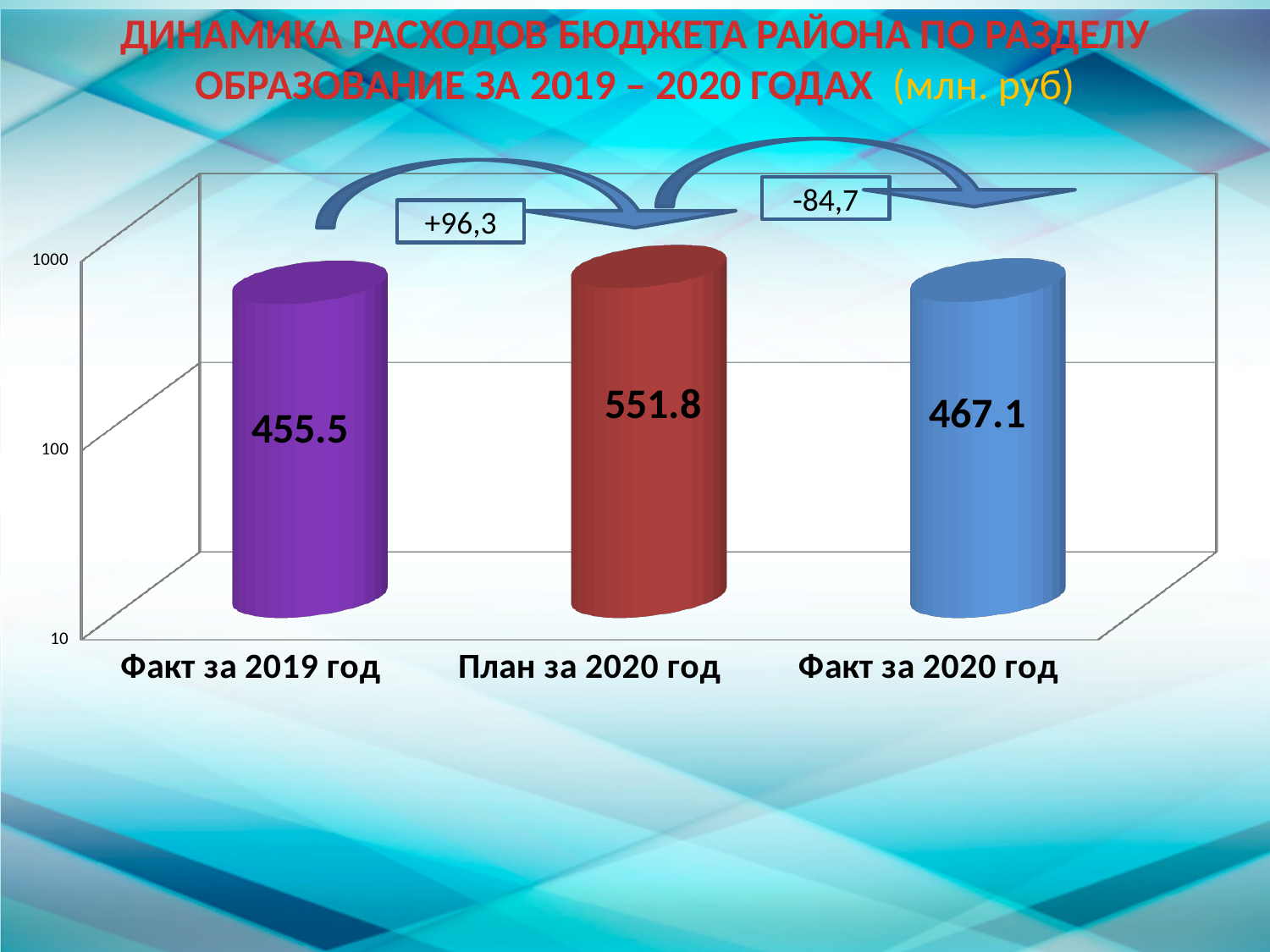
What is the difference between План за 2020 год and Факт за 2020 год? 84.7 What is the value for Факт за 2019 год? 455.5 Which category has the highest value? План за 2020 год Which is larger, Факт за 2020 год or Факт за 2019 год? Факт за 2020 год What is the value for План за 2020 год? 551.8 What is the value for Факт за 2020 год? 467.1 What is the difference between План за 2020 год and Факт за 2019 год? 96.3 What kind of chart is shown on the slide? bar chart Which category has the lowest value? Факт за 2019 год What unit is given in the chart title? млн. руб How many categories are shown on the chart? 3 Is the value for Факт за 2019 год greater or less than 100? greater